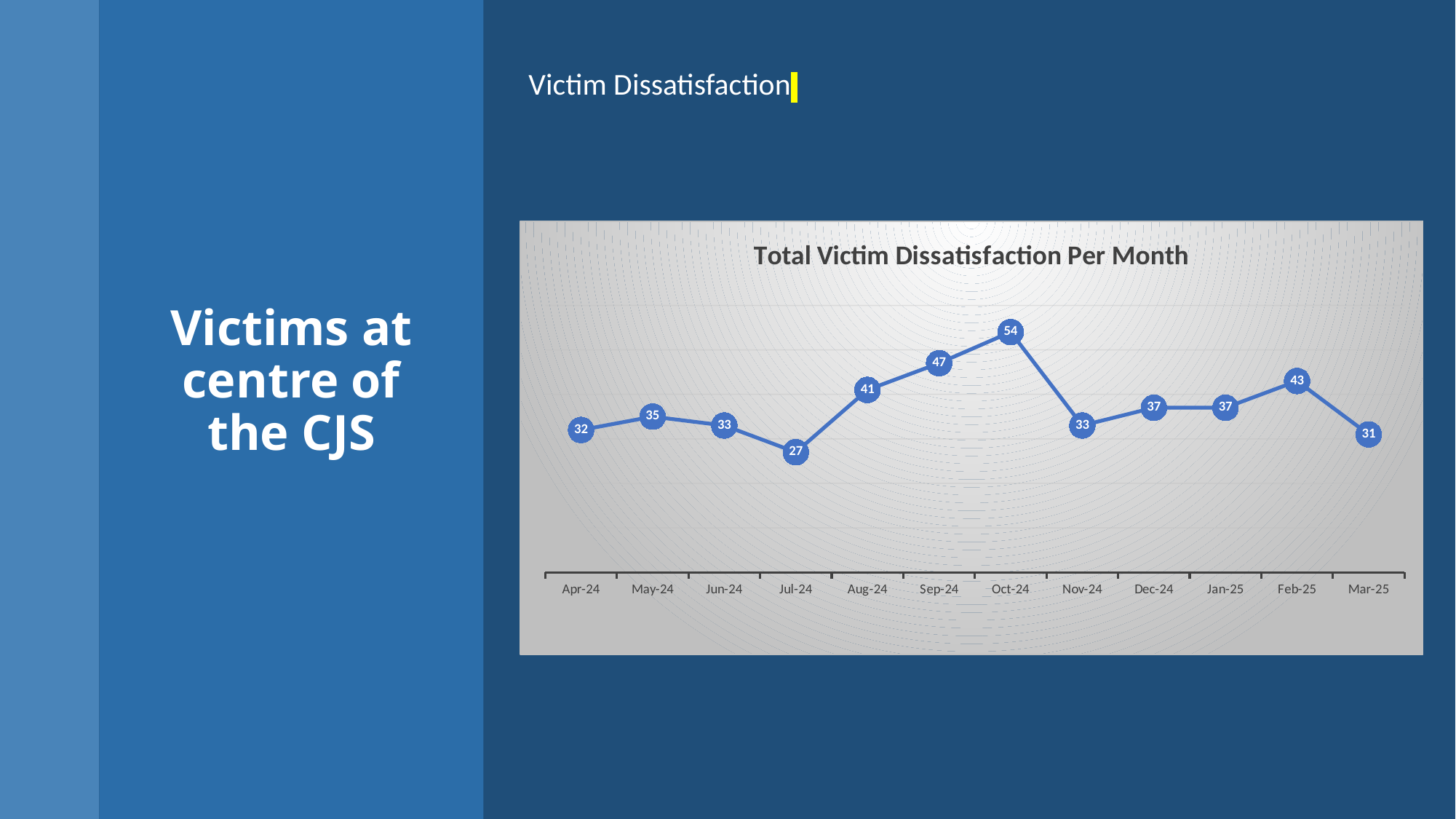
What is the title of the chart? Total Victim Dissatisfaction Per Month Which month has the highest value? Oct-24 What is the value for Mar-25? 31 What is the value for Jul-24? 27 How many months are plotted on the chart? 12 What is the difference between the values for Oct-24 and Nov-24? 21 What is the value for Oct-24? 54 What kind of chart is shown? Line chart Which month has the lowest value? Jul-24 What is the difference between the values for Feb-25 and Mar-25? 12 Do the values rise or fall from Jul-24 to Oct-24? Rise Which is larger, the value for Sep-24 or the value for Aug-24? Sep-24